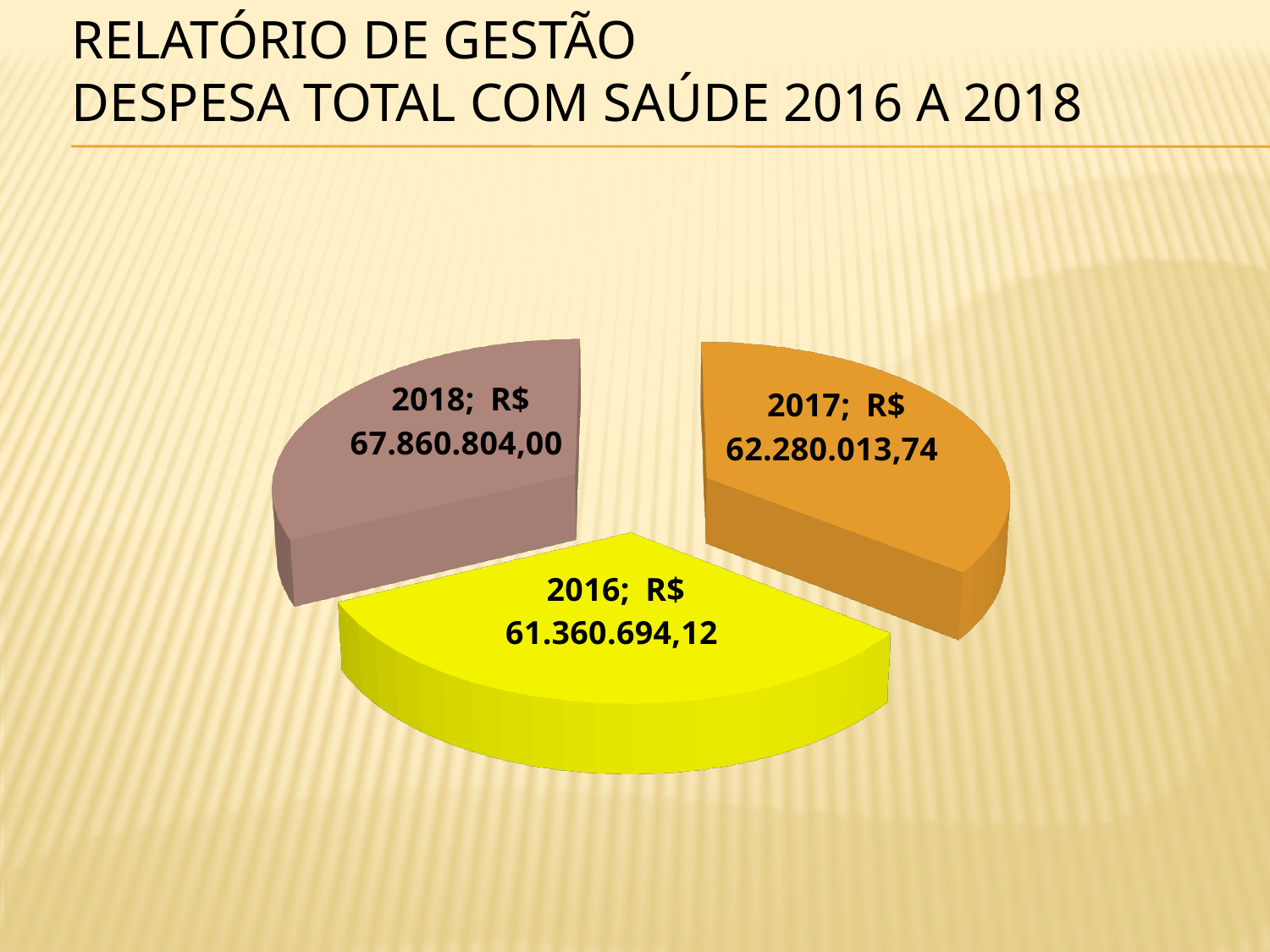
How many slices does the pie chart have? 3 What is the value shown for 2018? R$ 67.860.804,00 What is the difference between the 2018 and 2017 values? R$ 5.580.790,26 Do the values rise or fall from 2016 to 2018? Rise Which year has the highest total health expense? 2018 What is the value shown for 2017? R$ 62.280.013,74 What colour is the slice for 2016? Yellow What is the value shown for 2016? R$ 61.360.694,12 Which is larger, the value for 2017 or the value for 2016? 2017 What kind of chart is shown on the slide? Pie chart Which year has the lowest total health expense? 2016 What is the difference between the 2017 and 2016 values? R$ 919.319,62